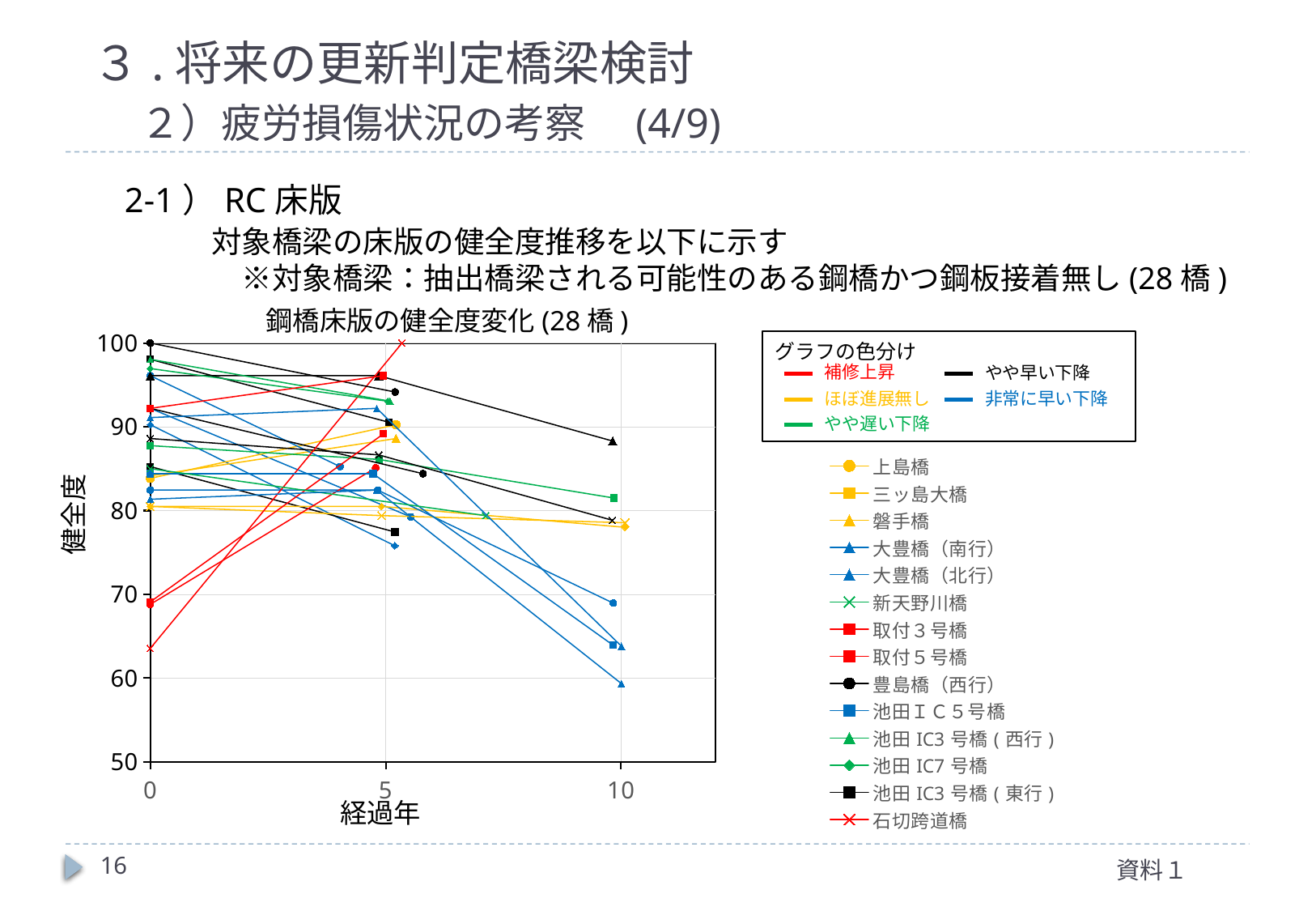
Is the highest plotted value at 0 経過年 greater or less than 90? greater Does the line for 石切跨道橋 rise or fall as 経過年 increases? rise According to the colour key, which colour represents 補修上昇? red Is the lowest plotted value at around 10 経過年 greater or less than 60? less Is the value for 石切跨道橋 at 0 経過年 greater or less than 70? less How many series does the chart legend list? 14 What kind of chart is shown on the slide? line chart What is the title of the chart? 鋼橋床版の健全度変化(28橋) How many bridges does the chart title say are plotted? 28